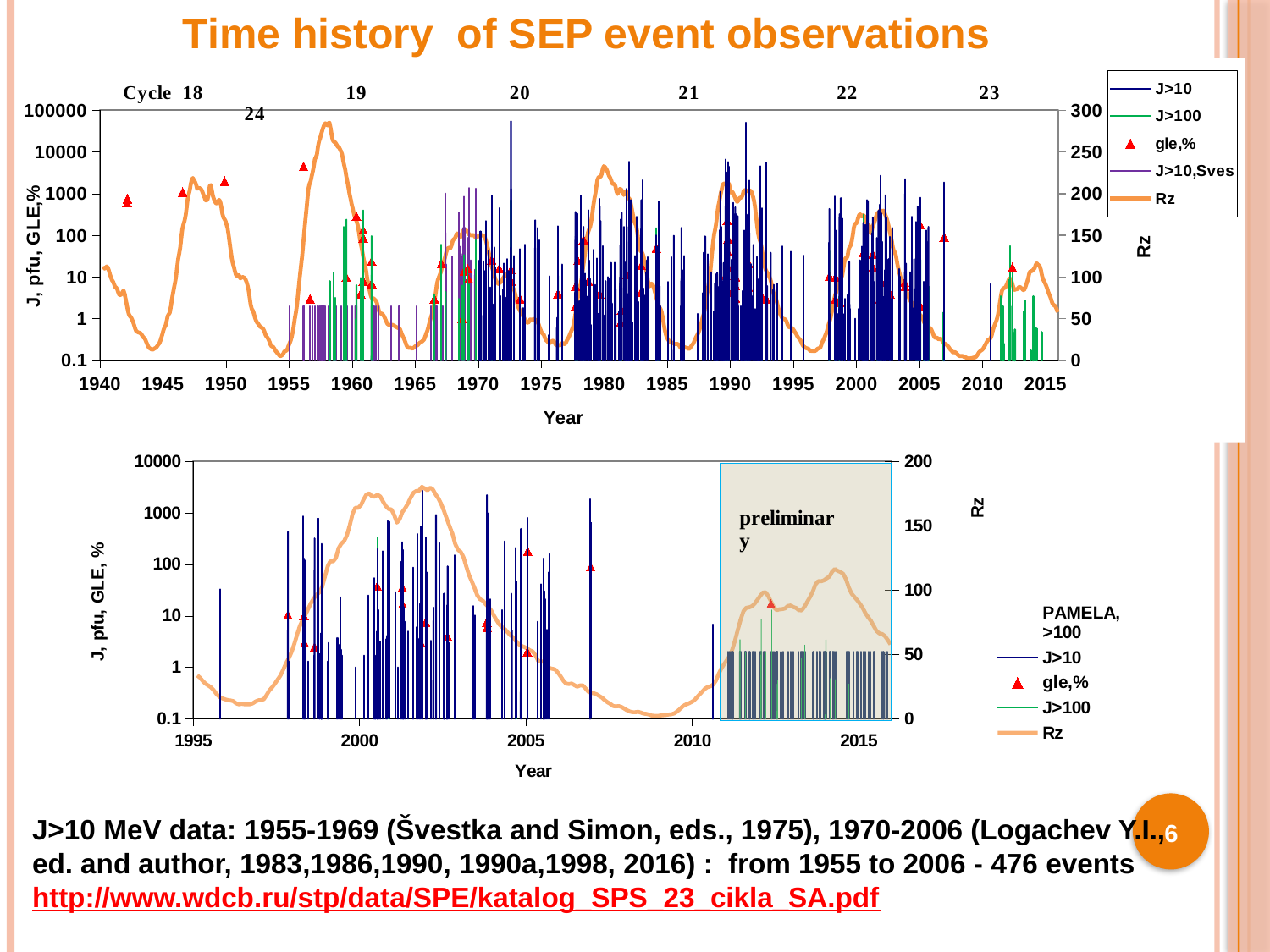
What is the first year shown on the x axis of the bottom chart? 1995 What is the x-axis label of the top chart? Year In the top chart, which series is drawn as red triangles? gle,% In the top chart, is the Rz value around 1965 greater or less than 50? less In the bottom chart, is the Rz value around 2009 greater or less than 50? less How many series does the legend of the bottom chart list? 5 What is the maximum value shown on the right-hand Rz axis of the top chart? 300 In the bottom chart, is the Rz value at its peak around 2000 greater or less than 150? greater How many series does the legend of the top chart list? 5 What is the maximum value shown on the right-hand Rz axis of the bottom chart? 200 In the top chart, which series is drawn as the thick orange line? Rz